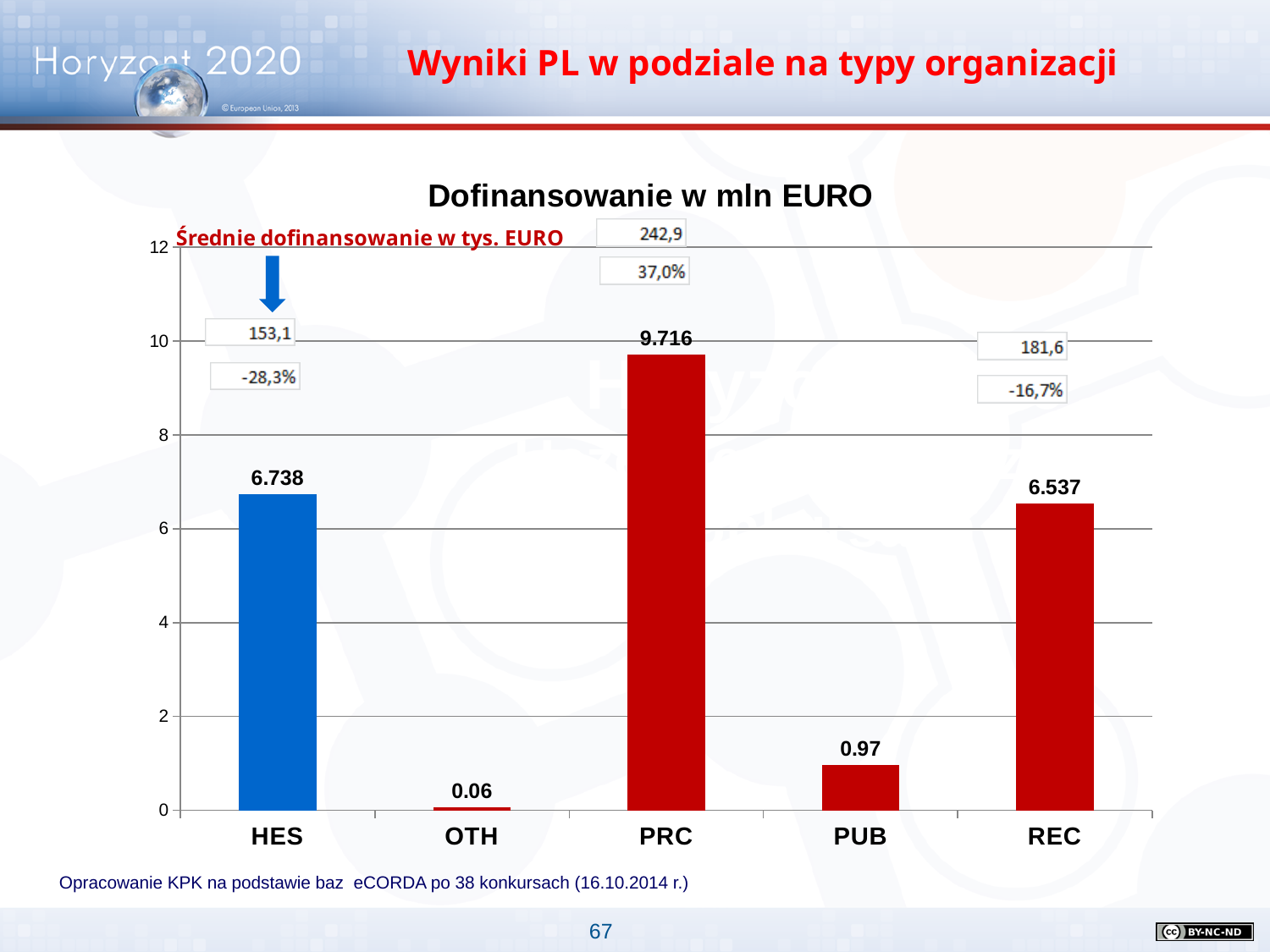
Which category has the lowest value in the chart? OTH What is the value for HES in the chart? 6.738 What is the title of the chart? Dofinansowanie w mln EURO According to the annotation above the PRC bar, what is the average funding in thousand EURO (Średnie dofinansowanie w tys. EURO) for PRC? 242,9 What is the value for OTH in the chart? 0.06 What is the value for PRC in the chart? 9.716 Which is larger, the value for HES or the value for REC? HES How many categories are shown on the x axis of the chart? 5 What is the value for PUB in the chart? 0.97 What kind of chart is shown on the slide? bar chart Which category has the highest value in the chart? PRC What is the difference between the values for PRC and REC? 3.179